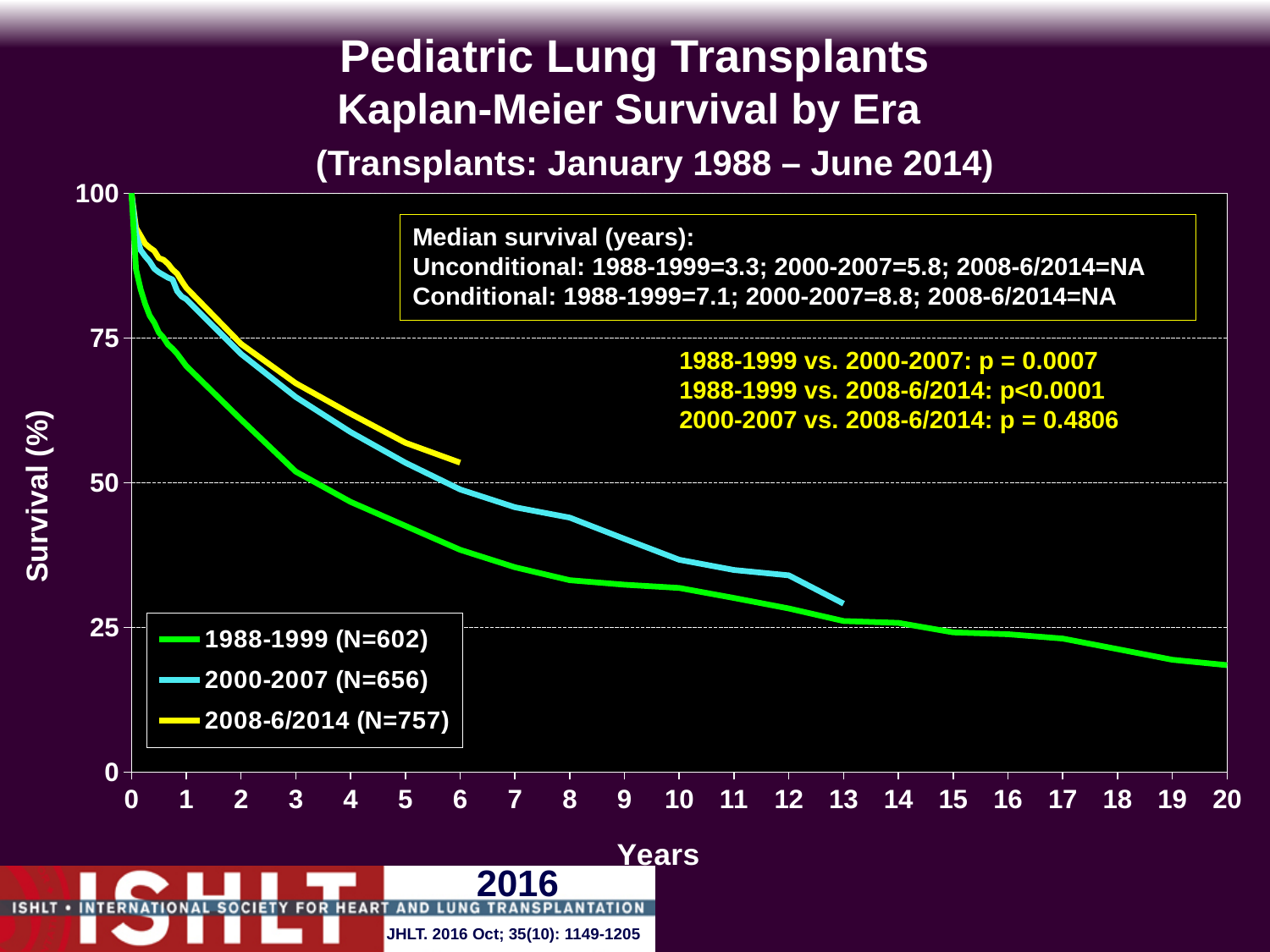
What is the conditional median survival in years for the 1988-1999 era? 7.1 What is the unconditional median survival in years for the 2000-2007 era? 5.8 How many eras (series) does the legend list? 3 What is the p-value for 1988-1999 vs. 2000-2007? 0.0007 Do the survival curves rise or fall as years increase? fall At 5 years, which era has the higher survival: 1988-1999 or 2008-6/2014? 2008-6/2014 What kind of chart is shown on the slide? line chart What is the label on the y axis? Survival (%) What is the number of transplants (N) for the 1988-1999 era shown in the legend? 602 Is the survival value for the 1988-1999 era at 20 years greater or less than 25? less Which era has the largest N in the legend? 2008-6/2014 (N=757) Is the survival value for the 2008-6/2014 era at 5 years greater or less than 50? greater